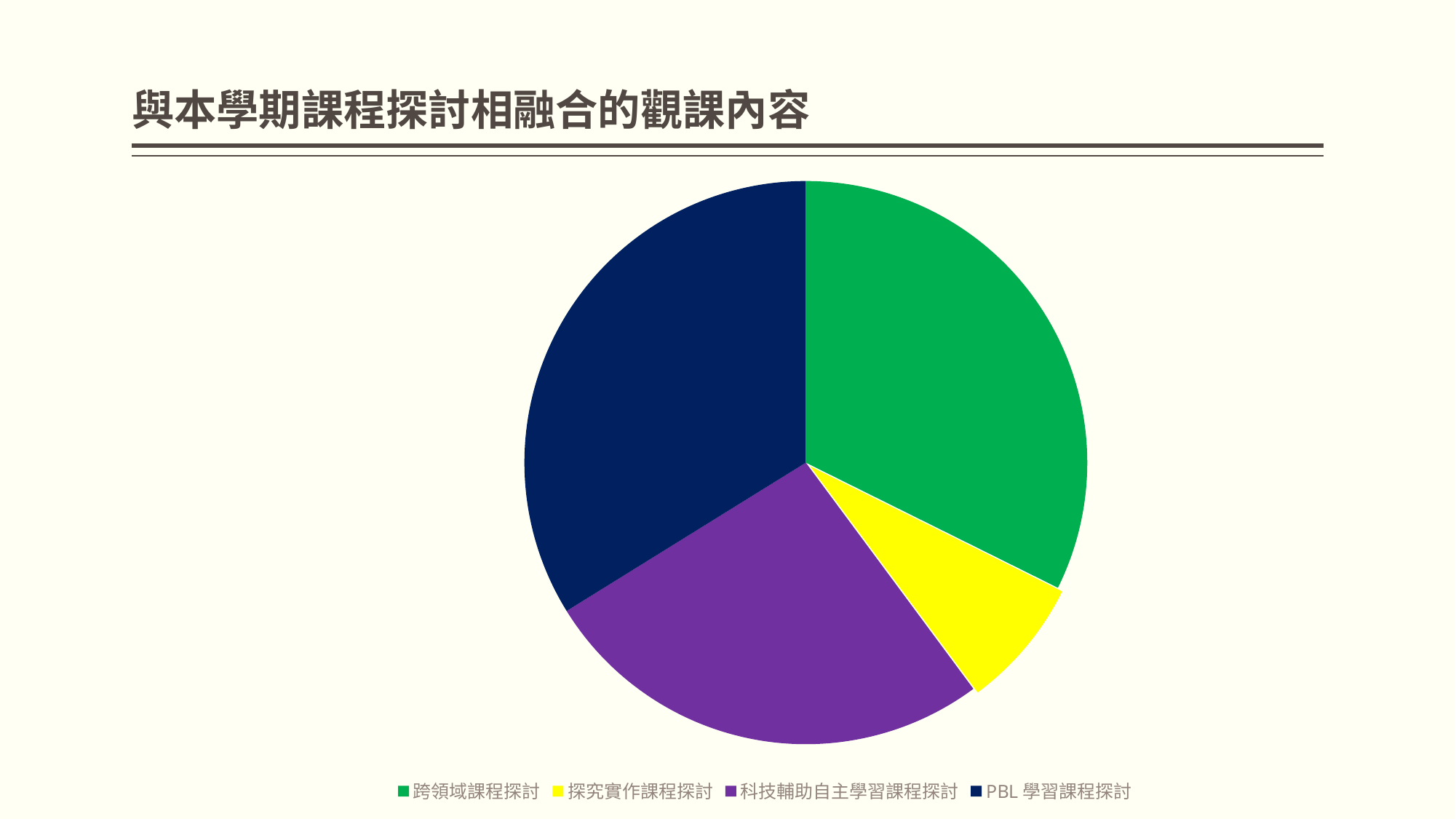
Which slice is larger, 跨領域課程探討 or 探究實作課程探討? 跨領域課程探討 Which slice is larger, PBL 學習課程探討 or 科技輔助自主學習課程探討? PBL 學習課程探討 What is the title of the slide containing the pie chart? 與本學期課程探討相融合的觀課內容 Which slice is larger, 探究實作課程探討 or 科技輔助自主學習課程探討? 科技輔助自主學習課程探討 Which category has the smallest slice in the pie chart? 探究實作課程探討 What kind of chart is shown on the slide? pie chart How many entries does the legend of the pie chart list? 4 How many slices does the pie chart have? 4 Which colour represents 探究實作課程探討 in the pie chart? yellow